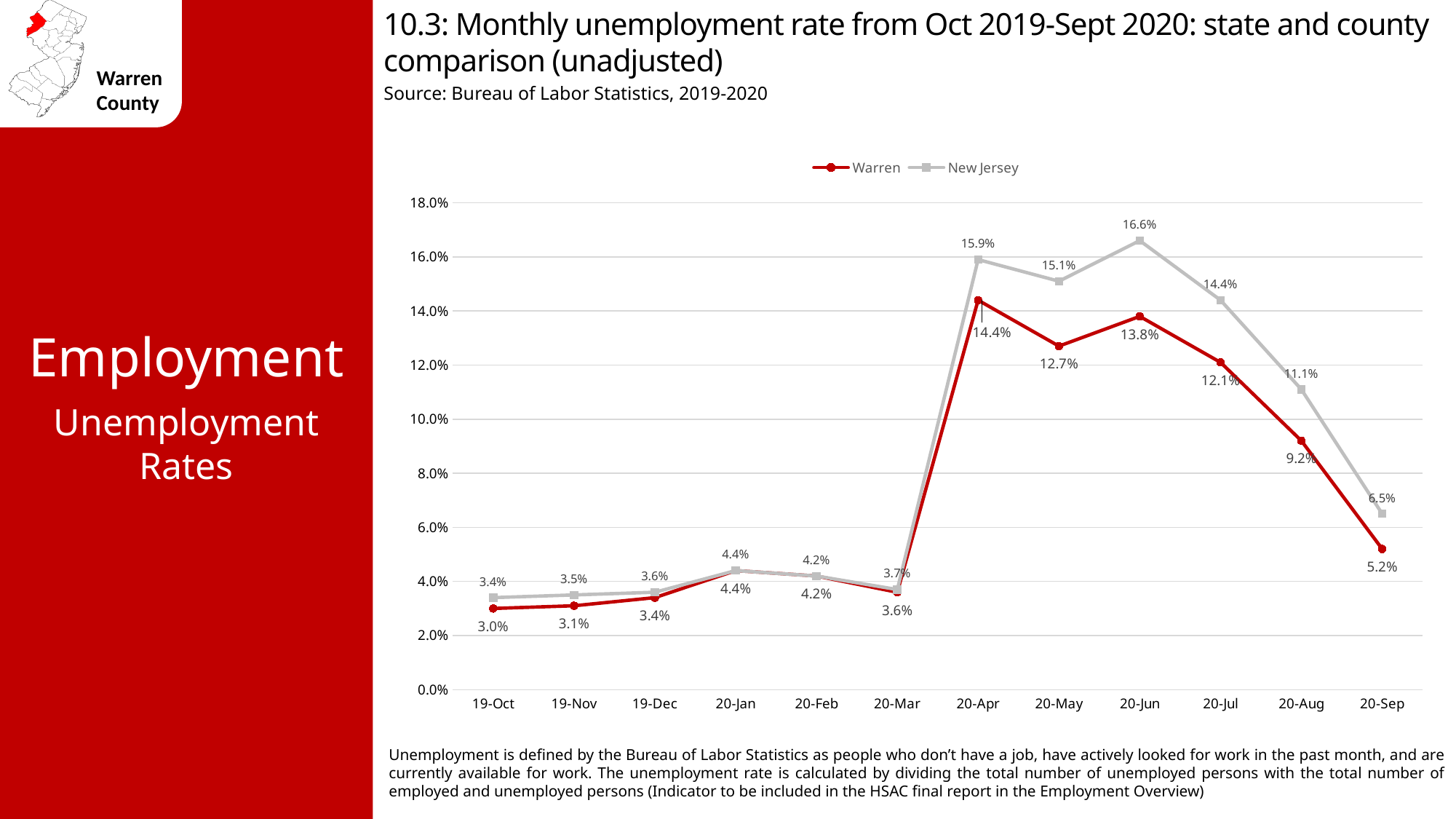
How many series does the legend list? 2 In 20-May, which series has the higher unemployment rate, Warren or New Jersey? New Jersey In which month is the Warren unemployment rate lowest? 19-Oct What kind of chart is shown on the slide? Line chart What is the difference between the New Jersey and Warren unemployment rates in 20-Jun? 2.8 percentage points How many months are plotted on the x axis? 12 What is the New Jersey unemployment rate for 20-Jun? 16.6% In which month does the Warren series reach its highest value? 20-Apr What is the Warren unemployment rate for 20-Apr? 14.4% What is the Warren unemployment rate for 20-Sep? 5.2% From 20-Jun to 20-Sep, does the Warren unemployment rate rise or fall? Fall In which month does the New Jersey series reach its highest value? 20-Jun